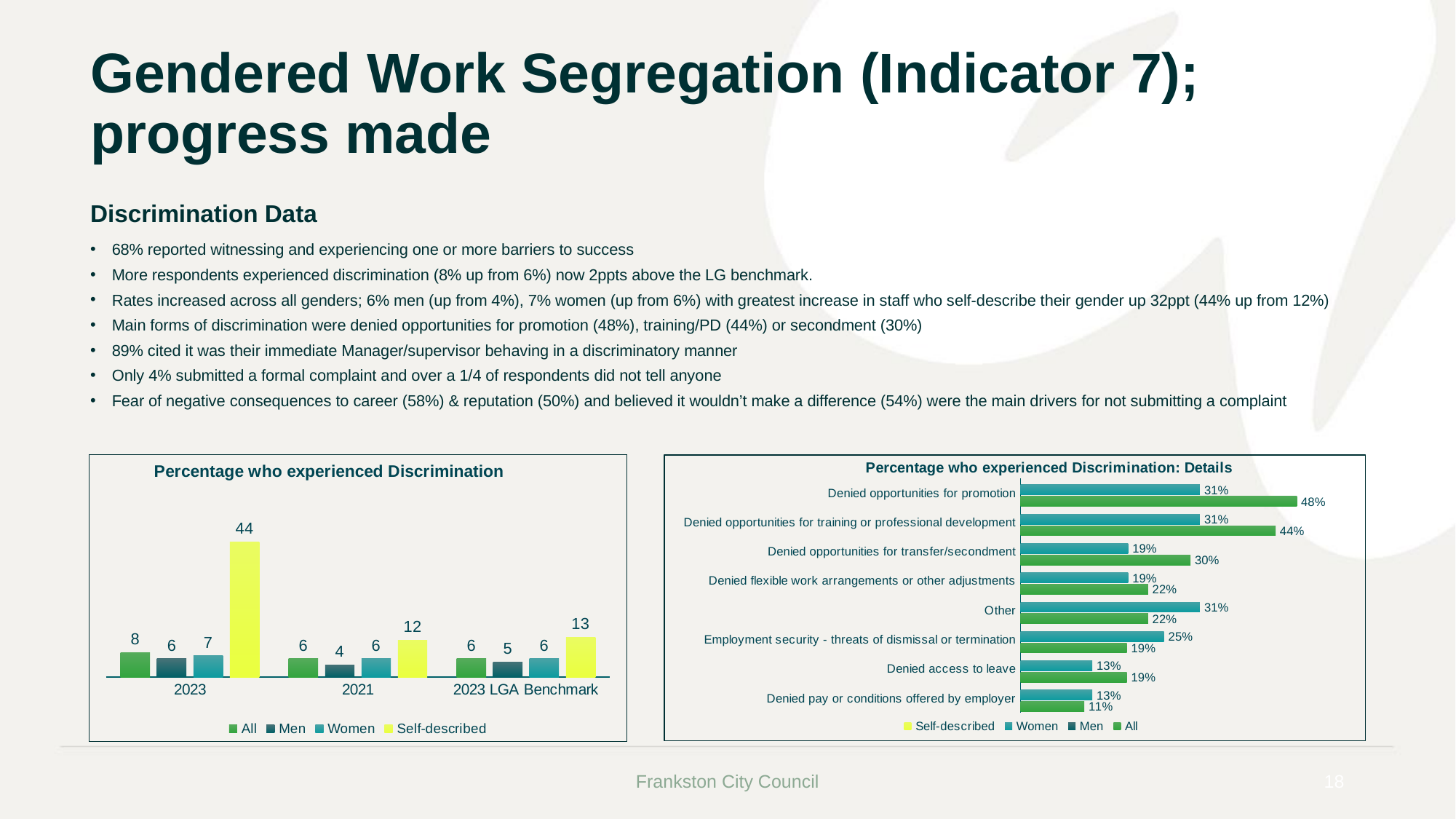
In the chart 'Percentage who experienced Discrimination: Details', what is the Women value for 'Employment security - threats of dismissal or termination'? 25% In the chart 'Percentage who experienced Discrimination', what is the value for Men in 2021? 4 In the chart 'Percentage who experienced Discrimination: Details', what is the difference between the All and Women values for 'Denied opportunities for training or professional development'? 13% What kind of chart is 'Percentage who experienced Discrimination: Details'? Bar chart In the chart 'Percentage who experienced Discrimination: Details', what is the All value for 'Denied opportunities for promotion'? 48% In the chart 'Percentage who experienced Discrimination', how many categories are shown on the x axis? 3 In the chart 'Percentage who experienced Discrimination: Details', which category has the lowest All value? Denied pay or conditions offered by employer In the chart 'Percentage who experienced Discrimination', how many series does the legend list? 4 In the chart 'Percentage who experienced Discrimination: Details', is the Women value or the All value larger for 'Other'? Women In the chart 'Percentage who experienced Discrimination', what is the value for Self-described in 2023? 44 In the chart 'Percentage who experienced Discrimination', what is the difference between the Self-described values for 2023 and 2021? 32 In the chart 'Percentage who experienced Discrimination', which category has the highest Self-described value? 2023